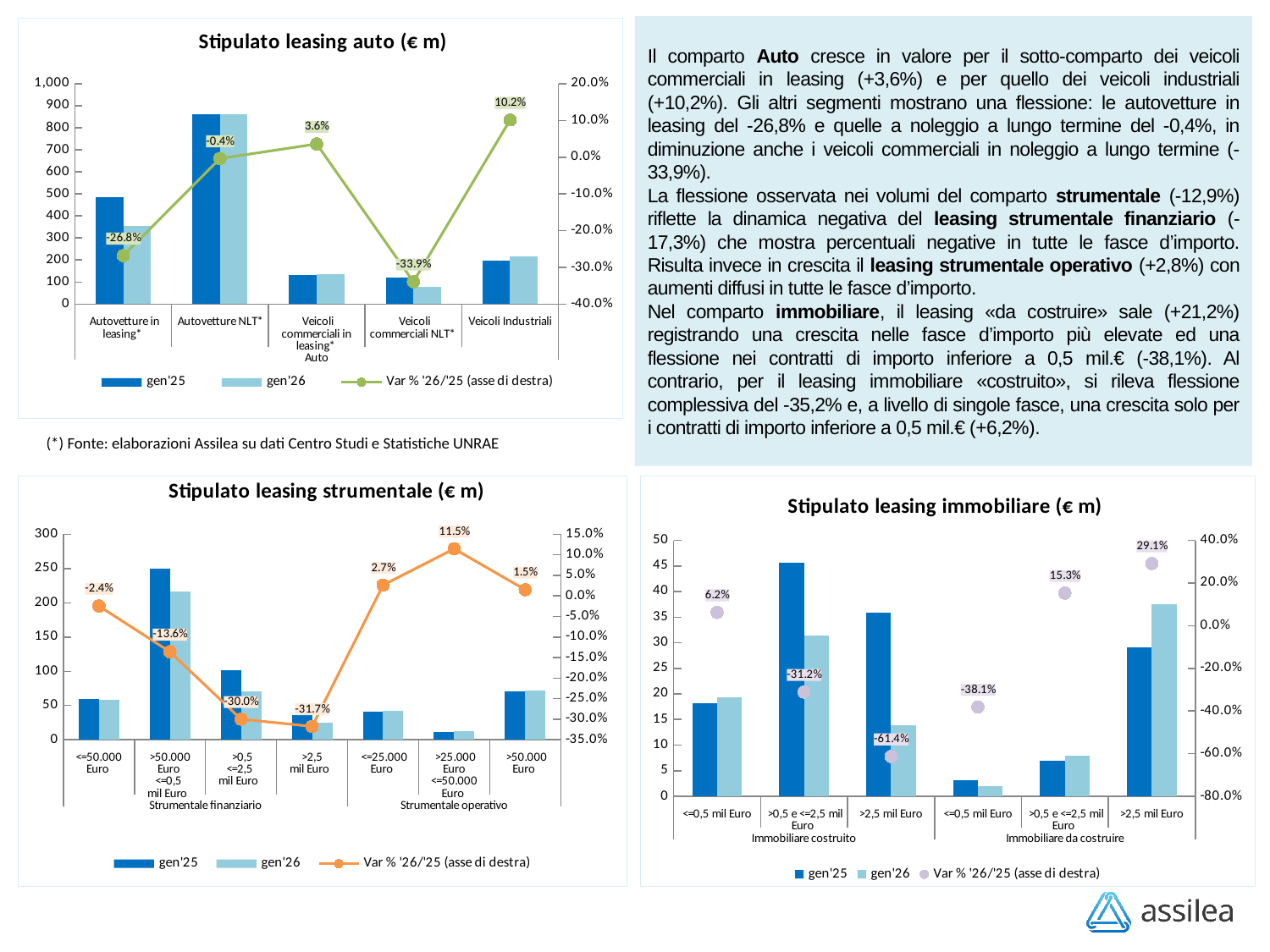
In the 'Stipulato leasing strumentale (€ m)' chart, what is the Var % '26/'25 value for the '>25.000 Euro <=50.000 Euro' category under Strumentale operativo? 11.5% In the 'Stipulato leasing immobiliare (€ m)' chart, what is the difference in percentage points between the Var % '26/'25 values for '>2,5 mil Euro' and '>0,5 e <=2,5 mil Euro' under Immobiliare da costruire? 13.8 percentage points How many categories are shown on the x axis of the 'Stipulato leasing auto (€ m)' chart? 5 In the 'Stipulato leasing auto (€ m)' chart, which category has the lowest Var % '26/'25 value? Veicoli commerciali NLT* In the 'Stipulato leasing auto (€ m)' chart, what is the Var % '26/'25 value for Veicoli Industriali? 10.2% What kind of chart is the 'Stipulato leasing immobiliare (€ m)' chart? Bar chart with percentage-change markers on a secondary axis How many series does the legend of the 'Stipulato leasing strumentale (€ m)' chart list? 3 In the 'Stipulato leasing strumentale (€ m)' chart, which category has the lowest Var % '26/'25 value? >2,5 mil Euro (Strumentale finanziario) In the 'Stipulato leasing immobiliare (€ m)' chart, what is the Var % '26/'25 value for '>2,5 mil Euro' under Immobiliare costruito? -61.4% In the 'Stipulato leasing strumentale (€ m)' chart, is the gen'25 value for '>50.000 Euro <=0,5 mil Euro' (Strumentale finanziario) greater or less than 200? greater In the 'Stipulato leasing auto (€ m)' chart, is the gen'25 value for Autovetture NLT* greater or less than 800? greater In the 'Stipulato leasing auto (€ m)' chart, which is larger for Autovetture in leasing*: the gen'25 bar or the gen'26 bar? gen'25